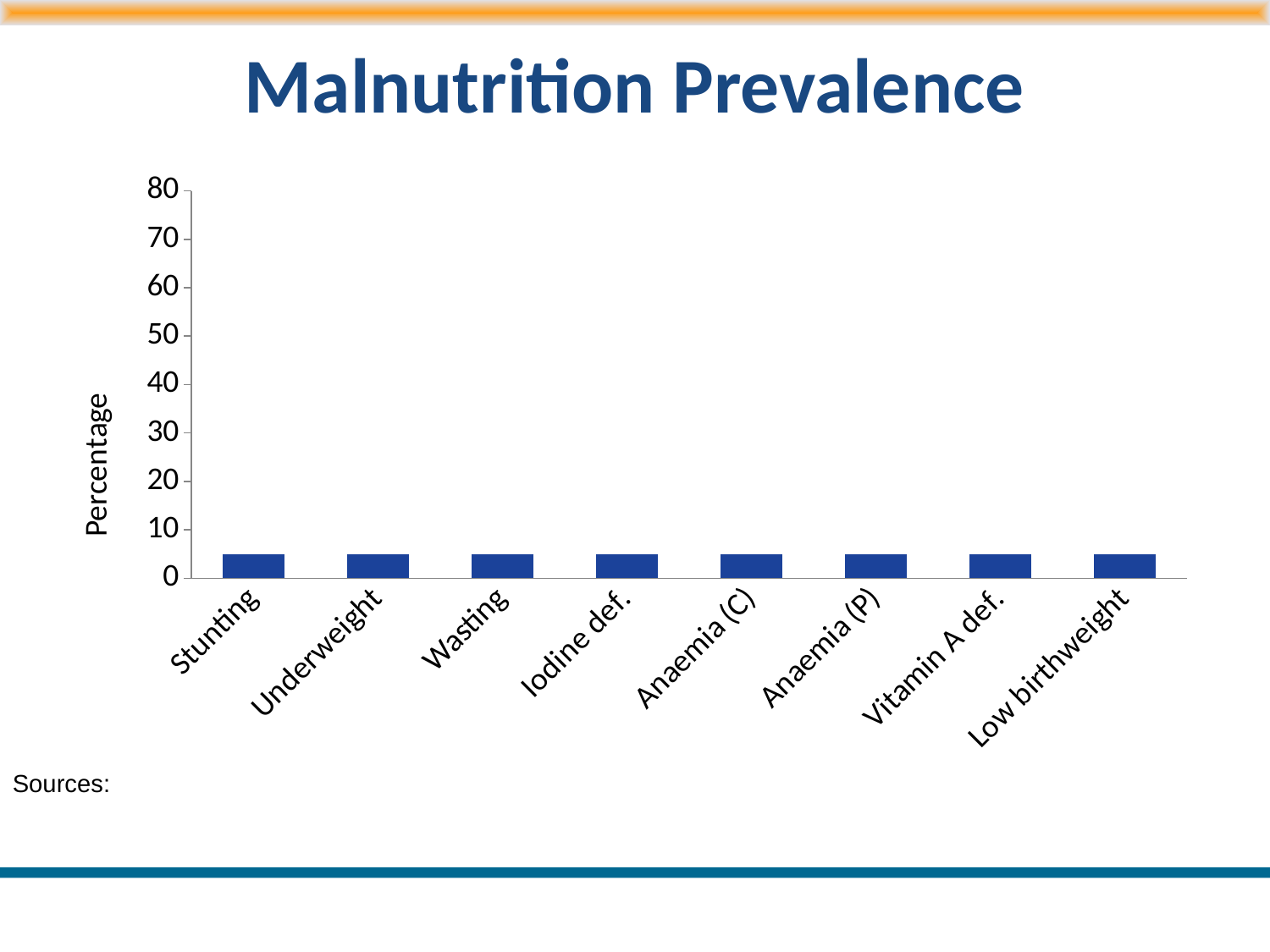
Is the value for Anaemia (C) greater or less than 30? less What is the label on the vertical axis of the chart? Percentage Is the value for Underweight greater or less than 20? less Is the value for Vitamin A def. greater or less than 10? less How many categories are plotted on the x axis of the chart? 8 Do the bar heights rise, fall, or stay flat from Stunting to Low birthweight? stay flat What kind of chart is shown on the slide? bar chart What is the title of the chart? Malnutrition Prevalence